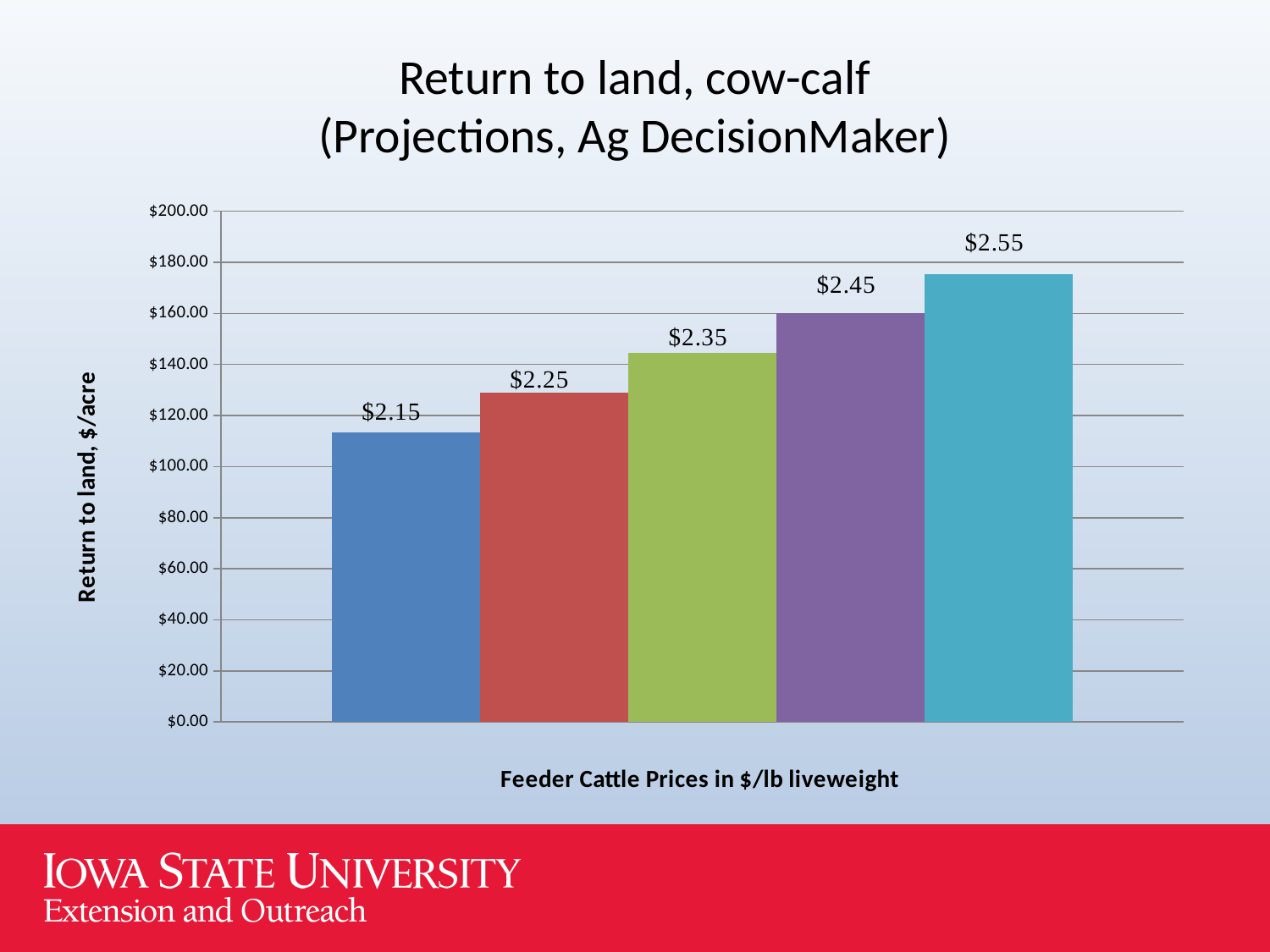
Is the return to land for the $2.35 feeder cattle price greater or less than $140.00? greater What kind of chart is shown on the slide? bar chart Which feeder cattle price has the lowest return to land? $2.15 Which feeder cattle price has the highest return to land? $2.55 Which has a larger return to land, the $2.45 feeder cattle price or the $2.25 feeder cattle price? $2.45 How many bars are plotted in the chart? 5 What is the label of the horizontal axis? Feeder Cattle Prices in $/lb liveweight What is the label of the vertical axis? Return to land, $/acre Do the returns to land rise or fall as the feeder cattle price increases along the x axis? rise Is the return to land for the $2.55 feeder cattle price greater or less than $160.00? greater Is the return to land for the $2.15 feeder cattle price greater or less than $120.00? less